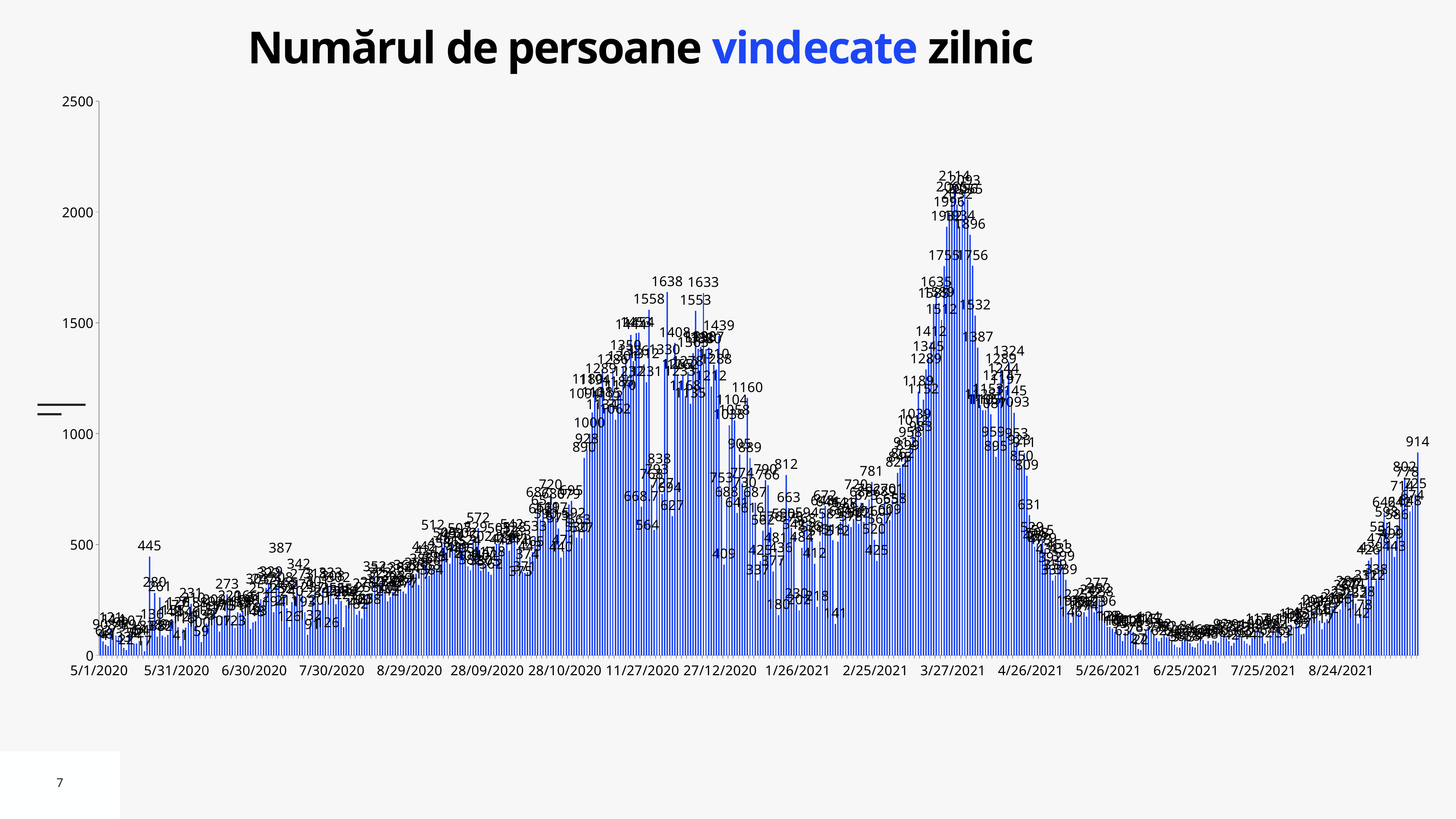
What is the value of the tall isolated spike in May 2020, before 5/31/2020? 445 Are the values around 6/25/2021 greater or less than 500? less What is the difference between the May 2020 spike (445) and the June 2020 spike labeled 387? 58 What is the value of the last (rightmost) bar on the chart? 914 What kind of chart is shown on the slide? bar chart What is the highest value labeled on the chart, at the peak of the spring 2021 wave? 2114 What is the difference between the peak value 2114 and the late-2020 peak value 1638? 476 Which is larger: the peak of the spring 2021 wave (2114) or the peak of the late 2020 wave (1638)? 2114 Is the value of the rightmost bar (914) greater or less than 1000? less What is the title of the chart? Numărul de persoane vindecate zilnic What is the highest value labeled in the late 2020 wave (around 11/27/2020)? 1638 Do the values rise or fall from 7/25/2021 to the end of the chart? rise